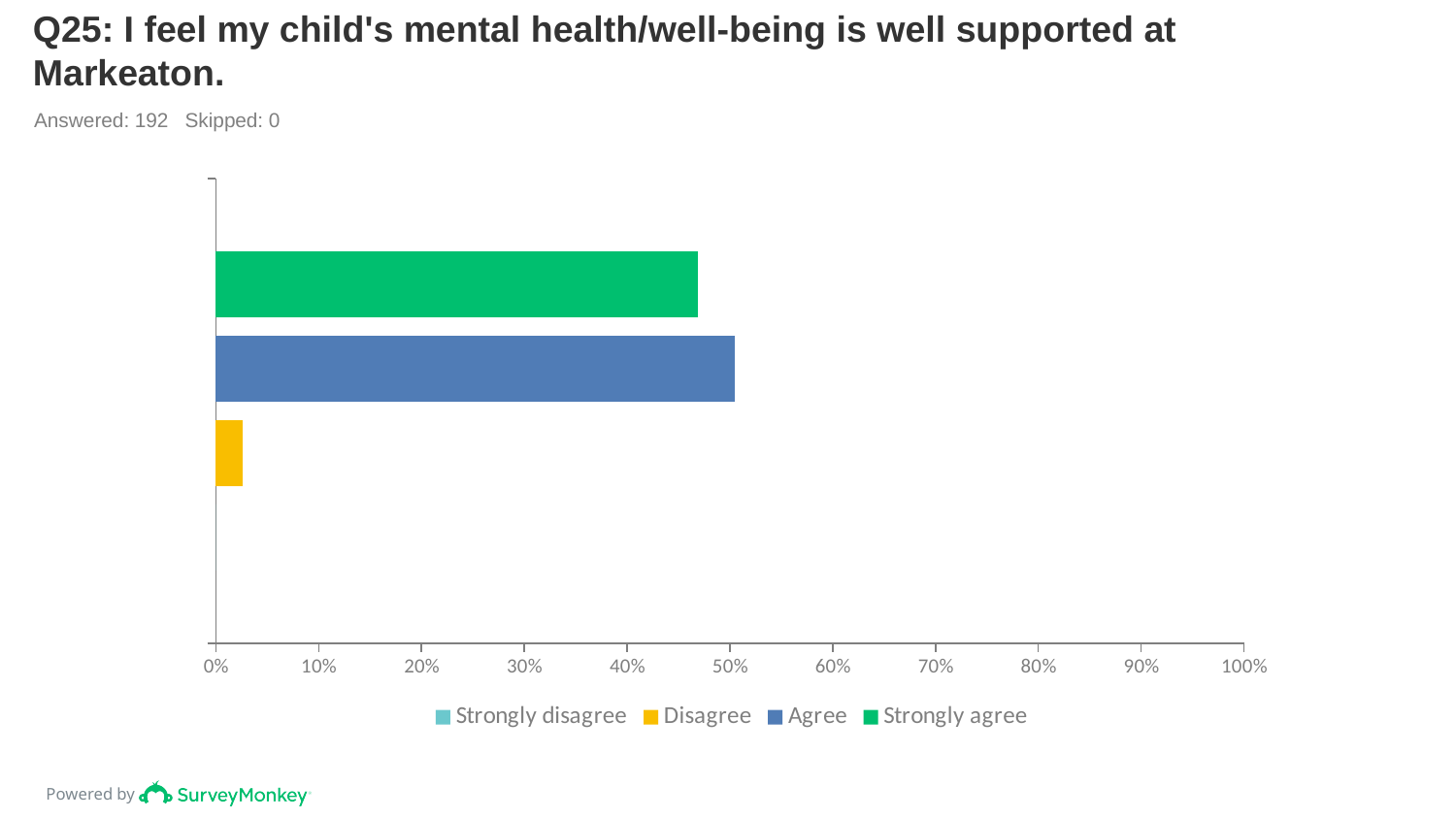
Which response category has the lowest value? Strongly disagree Is the value for Agree greater or less than 40%? greater Is the value for Strongly agree greater or less than 40%? greater Which response category has the longest bar? Agree Is the value for Strongly agree greater or less than 50%? less Which is larger, the value for Agree or the value for Strongly agree? Agree Which is larger, the value for Disagree or the value for Strongly agree? Strongly agree How many response categories does the legend list? 4 What kind of chart is shown on the slide? bar chart How many respondents answered this question according to the slide? 192 What colour is the bar for Disagree? yellow